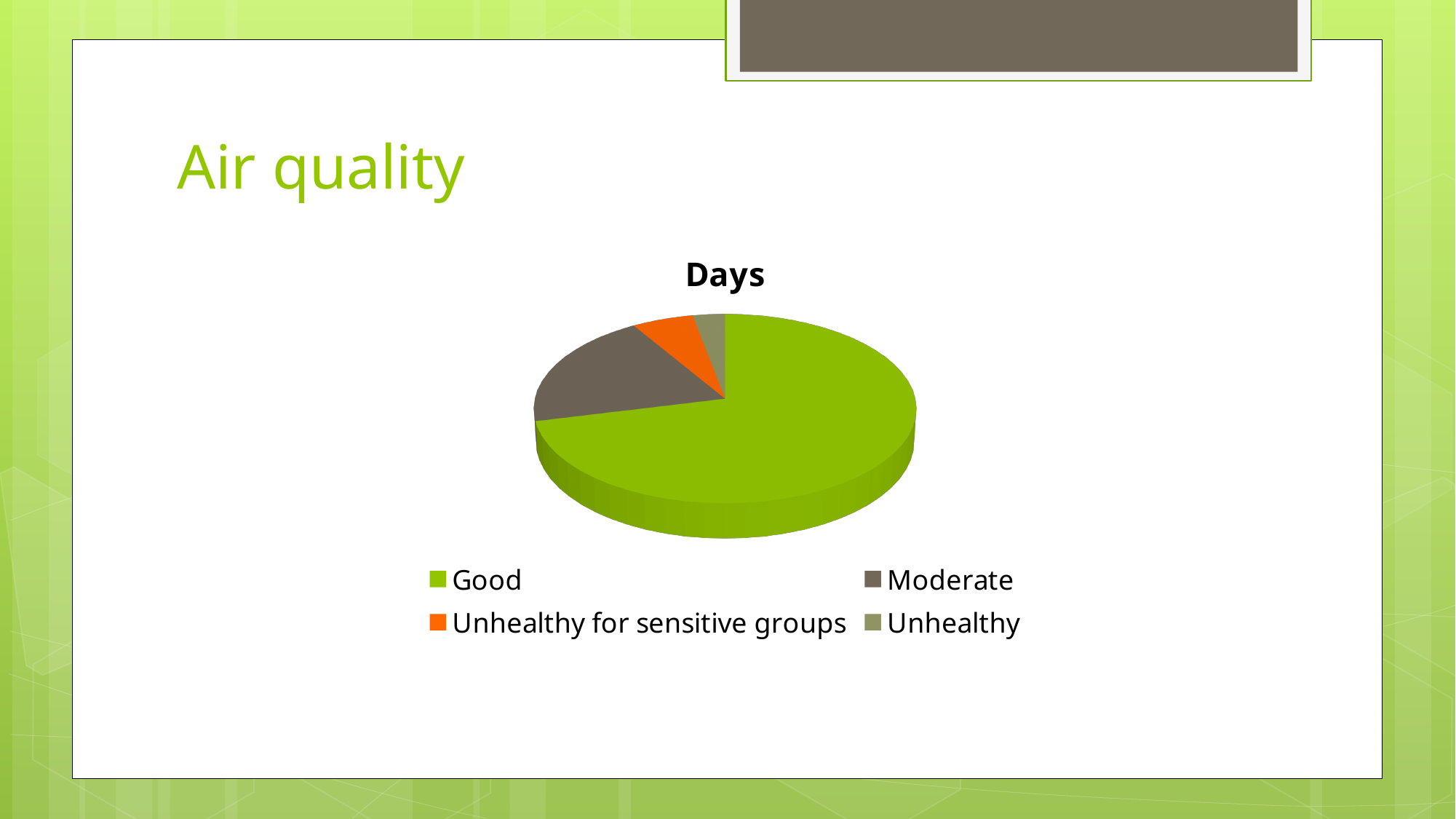
Which category has the largest slice of the pie? Good Which slice is larger, Moderate or Unhealthy for sensitive groups? Moderate Which category has the smallest slice of the pie? Unhealthy Which slice is larger, Unhealthy for sensitive groups or Unhealthy? Unhealthy for sensitive groups What is the title of the chart? Days What kind of chart is shown on the slide? pie chart Which category has the second-largest slice of the pie? Moderate Which category is shown in orange in the pie chart? Unhealthy for sensitive groups How many categories does the pie chart have? 4